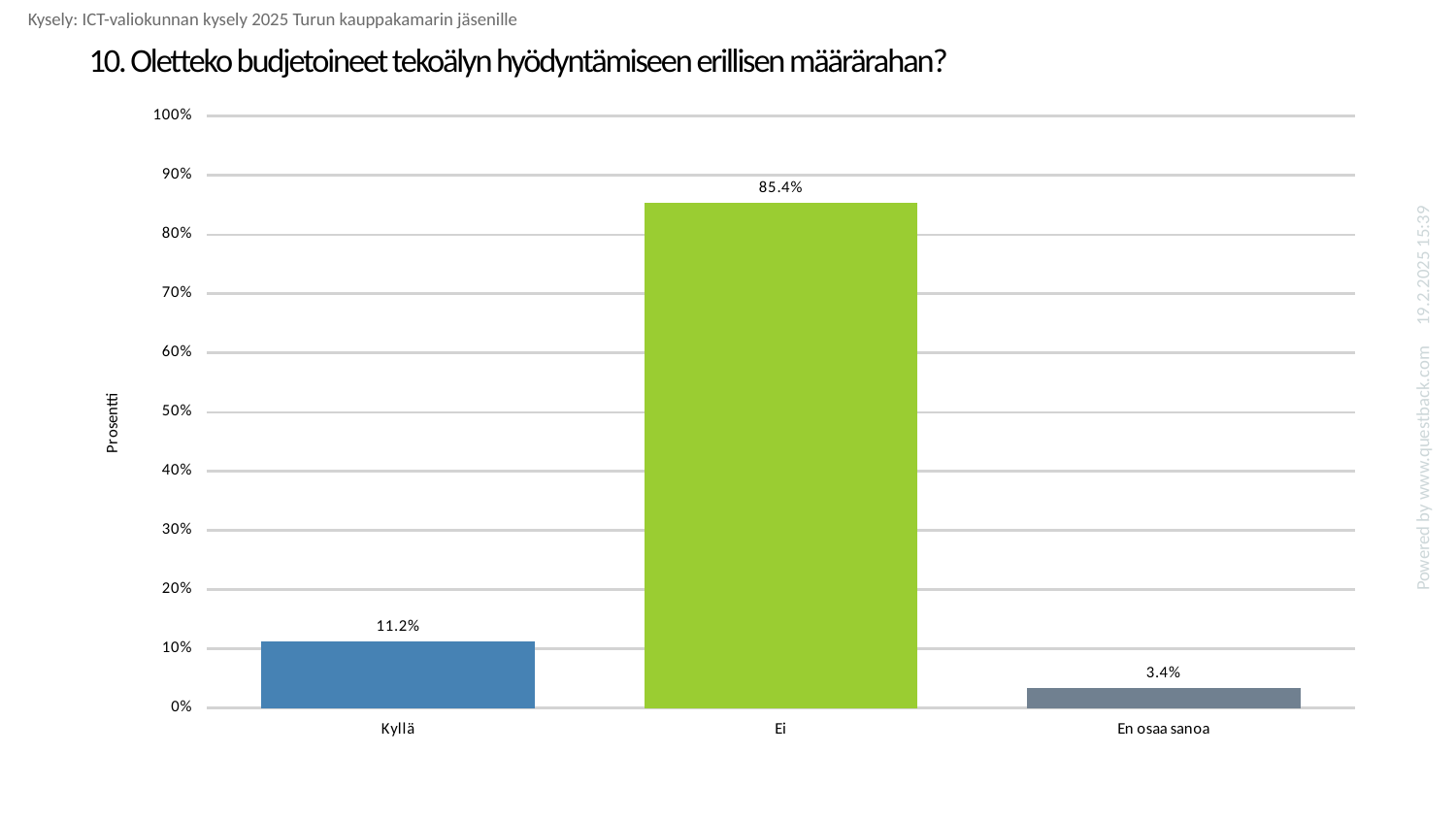
Is the value for Ei greater or less than 80%? greater Which category has the highest value? Ei What is the label of the y axis? Prosentti What is the difference between the values for Kyllä and En osaa sanoa? 7.8% What is the difference between the values for Ei and Kyllä? 74.2% Which category has the lowest value? En osaa sanoa What is the value for En osaa sanoa? 3.4% How many categories are shown on the x axis? 3 What kind of chart is shown on the slide? bar chart What is the value for Kyllä? 11.2% What is the value for Ei? 85.4% Which is larger, the value for Kyllä or the value for En osaa sanoa? Kyllä